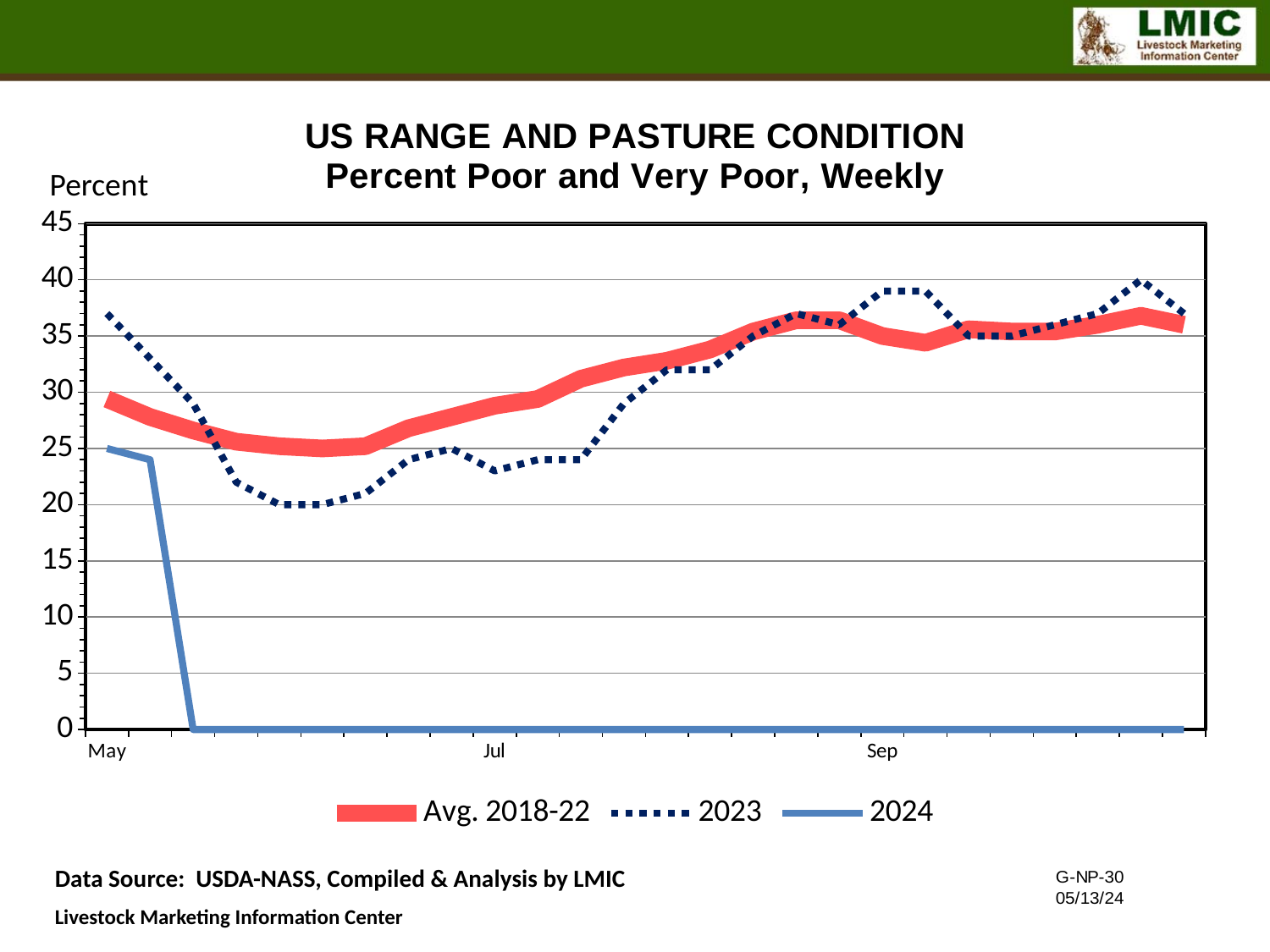
At the Jul tick, which series has the higher value: Avg. 2018-22 or 2023? Avg. 2018-22 How many series does the legend list? 3 What are the three series named in the legend? Avg. 2018-22, 2023, 2024 Does the Avg. 2018-22 line rise or fall between Jul and Sep? Rise What is the label on the vertical axis of the chart? Percent Is the lowest 2023 value (in early June) greater or less than 25? less What kind of chart is shown on the slide? Line chart Is the 2023 value at the start of May greater or less than 35? greater Is the 2024 value at the start of May greater or less than 20? greater Does the 2023 line rise or fall from the start of May to early June? Fall At the start of May, which series has the higher value: 2023 or Avg. 2018-22? 2023